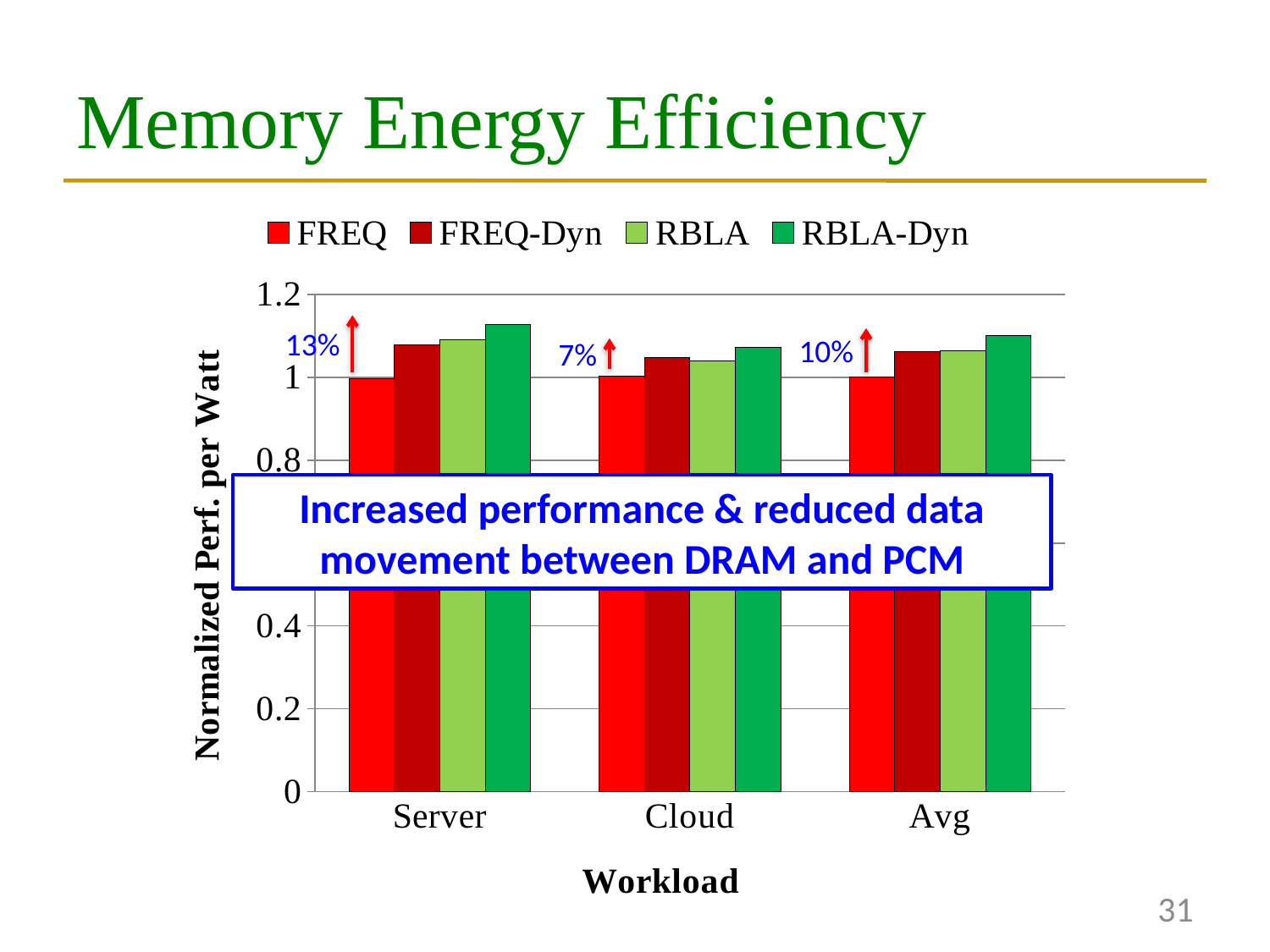
Is the FREQ-Dyn value for Cloud greater or less than 1? greater Which series has the highest bar for the Server workload? RBLA-Dyn What is the title of the y axis? Normalized Perf. per Watt Is the RBLA-Dyn value for Server greater or less than 1? greater Which workload has the highest RBLA-Dyn bar overall? Server Which series has the lowest bar for the Cloud workload? FREQ Which is larger, the RBLA-Dyn value for Server or the RBLA-Dyn value for Cloud? Server How many workload categories are shown on the x axis? 3 How many series does the legend list? 4 What percentage improvement is annotated above the Server workload? 13% What kind of chart is shown on the slide? bar chart